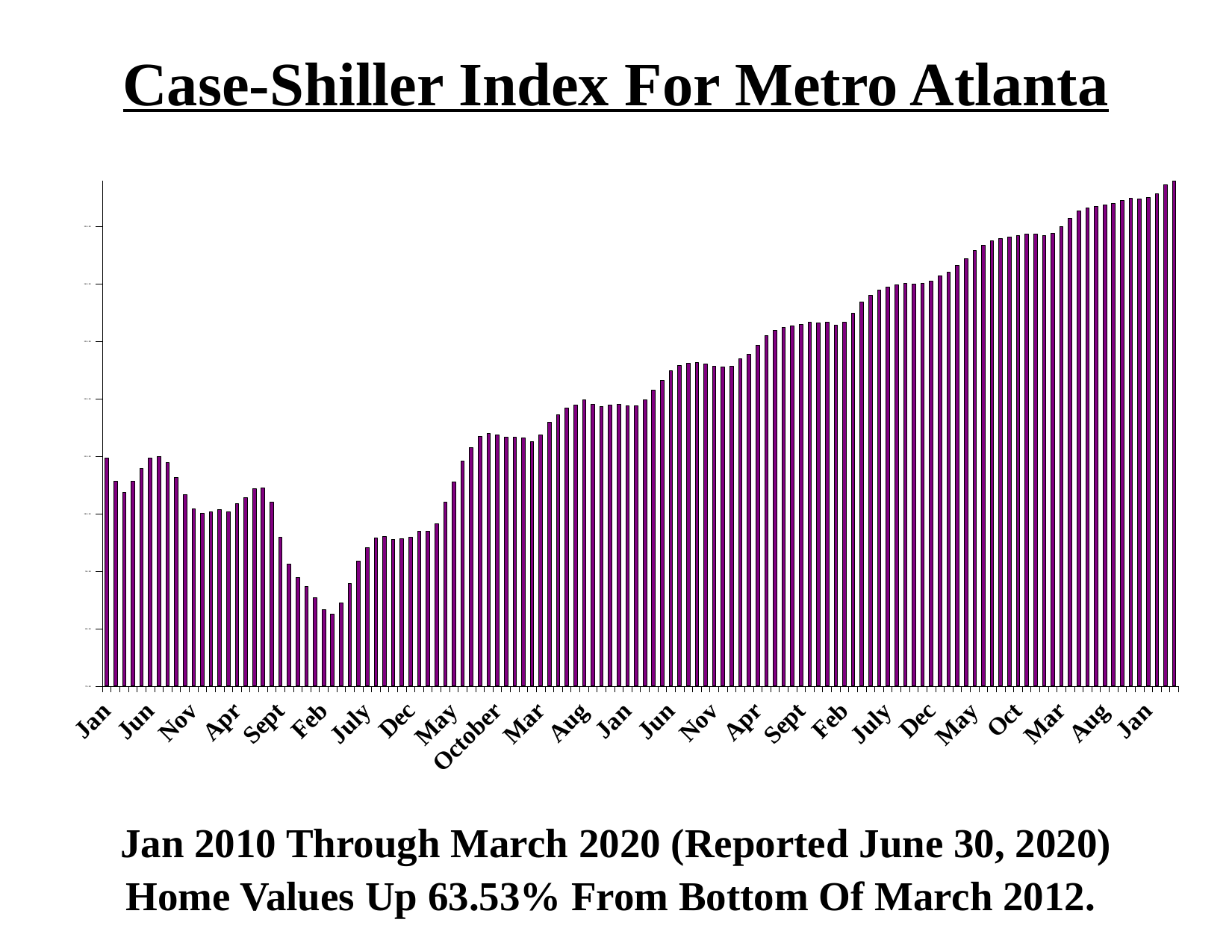
According to the slide, by what percentage are home values up from the bottom of March 2012? 63.53% What colour are the bars in the chart? purple Which is larger: the first bar (Jan) or the last bar on the right? the last bar Between the first 'Jan' label and the 'Feb' label, do the values rise or fall? fall Is the highest bar at the left end or the right end of the chart? right end What is the title of the chart? Case-Shiller Index For Metro Atlanta Which is larger: the bar at the first 'Jan' label or the bar at the 'Feb' label? Jan What kind of chart is shown on the slide? bar chart Which is larger: the bar at the first 'Nov' label or the bar at the first 'Dec' label? Nov Overall, do the values rise or fall from the left end of the x axis to the right end? rise